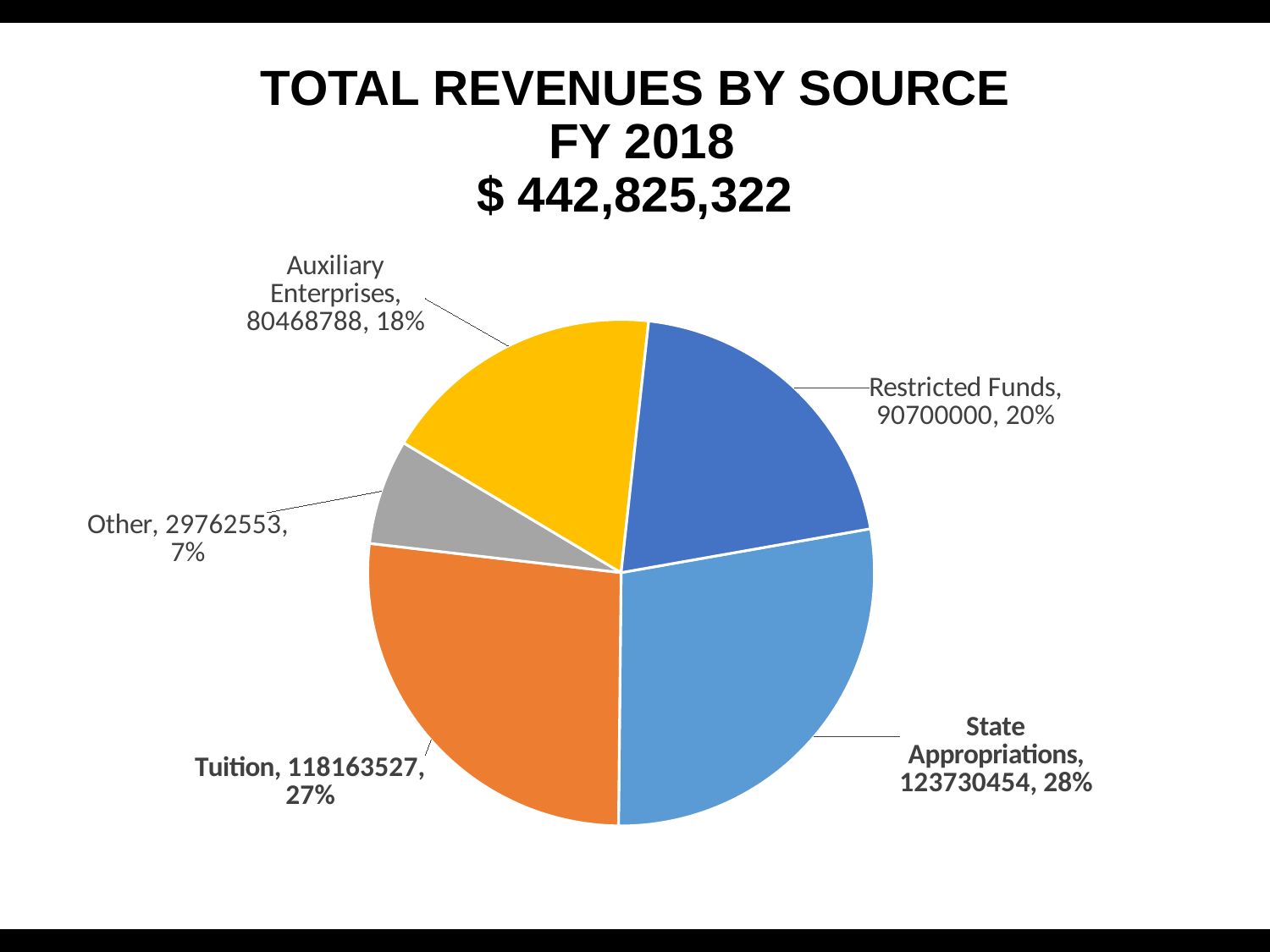
How many slices does the pie chart have? 5 What is the value for Other? 29762553 What is the value for Restricted Funds? 90700000 What kind of chart is shown on the slide? Pie chart What share of the pie does State Appropriations represent? 28% What is the value for Tuition? 118163527 Which source has the smallest share of total revenues? Other What is the difference between the State Appropriations value and the Tuition value? 5566927 Which source has the largest share of total revenues? State Appropriations What share of the pie does Auxiliary Enterprises represent? 18% Which is larger, Restricted Funds or Auxiliary Enterprises? Restricted Funds What is the difference between the Restricted Funds value and the Auxiliary Enterprises value? 10231212